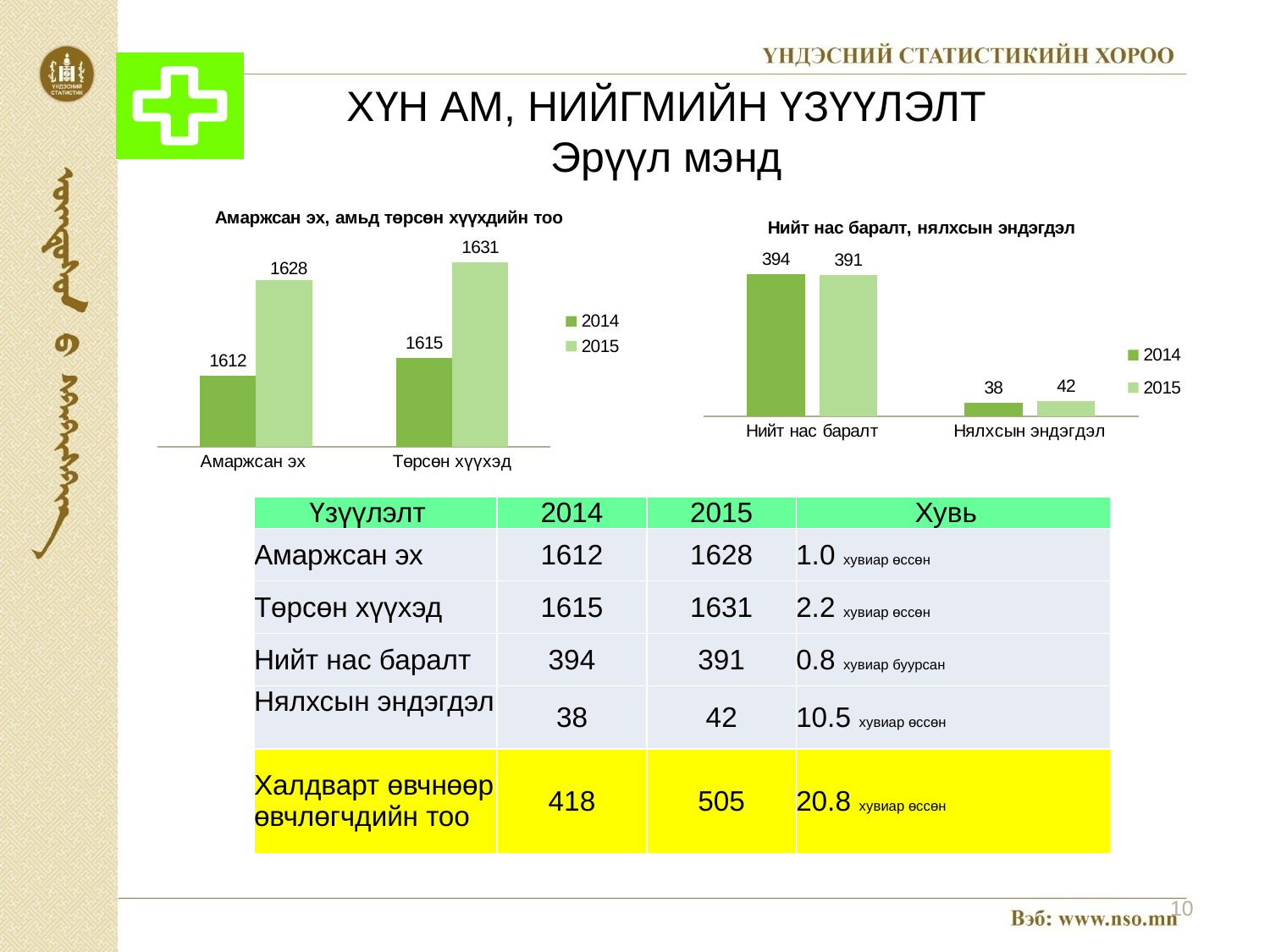
In the chart titled "Нийт нас баралт, нялхсын эндэгдэл", which category has the highest 2014 value? Нийт нас баралт In the chart titled "Амаржсан эх, амьд төрсөн хүүхдийн тоо", which is larger for Амаржсан эх: the 2014 value or the 2015 value? 2015 In the chart titled "Амаржсан эх, амьд төрсөн хүүхдийн тоо", what is the 2015 value for Төрсөн хүүхэд? 1631 In the chart titled "Амаржсан эх, амьд төрсөн хүүхдийн тоо", what is the 2014 value for Амаржсан эх? 1612 In the chart titled "Амаржсан эх, амьд төрсөн хүүхдийн тоо", how many series does the legend list? 2 In the chart titled "Нийт нас баралт, нялхсын эндэгдэл", how many categories are shown on the x axis? 2 In the chart titled "Амаржсан эх, амьд төрсөн хүүхдийн тоо", what is the difference between the 2015 and 2014 values for Төрсөн хүүхэд? 16 In the chart titled "Нийт нас баралт, нялхсын эндэгдэл", what is the 2015 value for Нялхсын эндэгдэл? 42 In the chart titled "Нийт нас баралт, нялхсын эндэгдэл", what is the difference between the 2014 and 2015 values for Нийт нас баралт? 3 In the chart titled "Нийт нас баралт, нялхсын эндэгдэл", what is the 2014 value for Нийт нас баралт? 394 What kind of chart is the chart titled "Нийт нас баралт, нялхсын эндэгдэл"? Bar chart In the chart titled "Амаржсан эх, амьд төрсөн хүүхдийн тоо", what are the two legend entries? 2014 and 2015